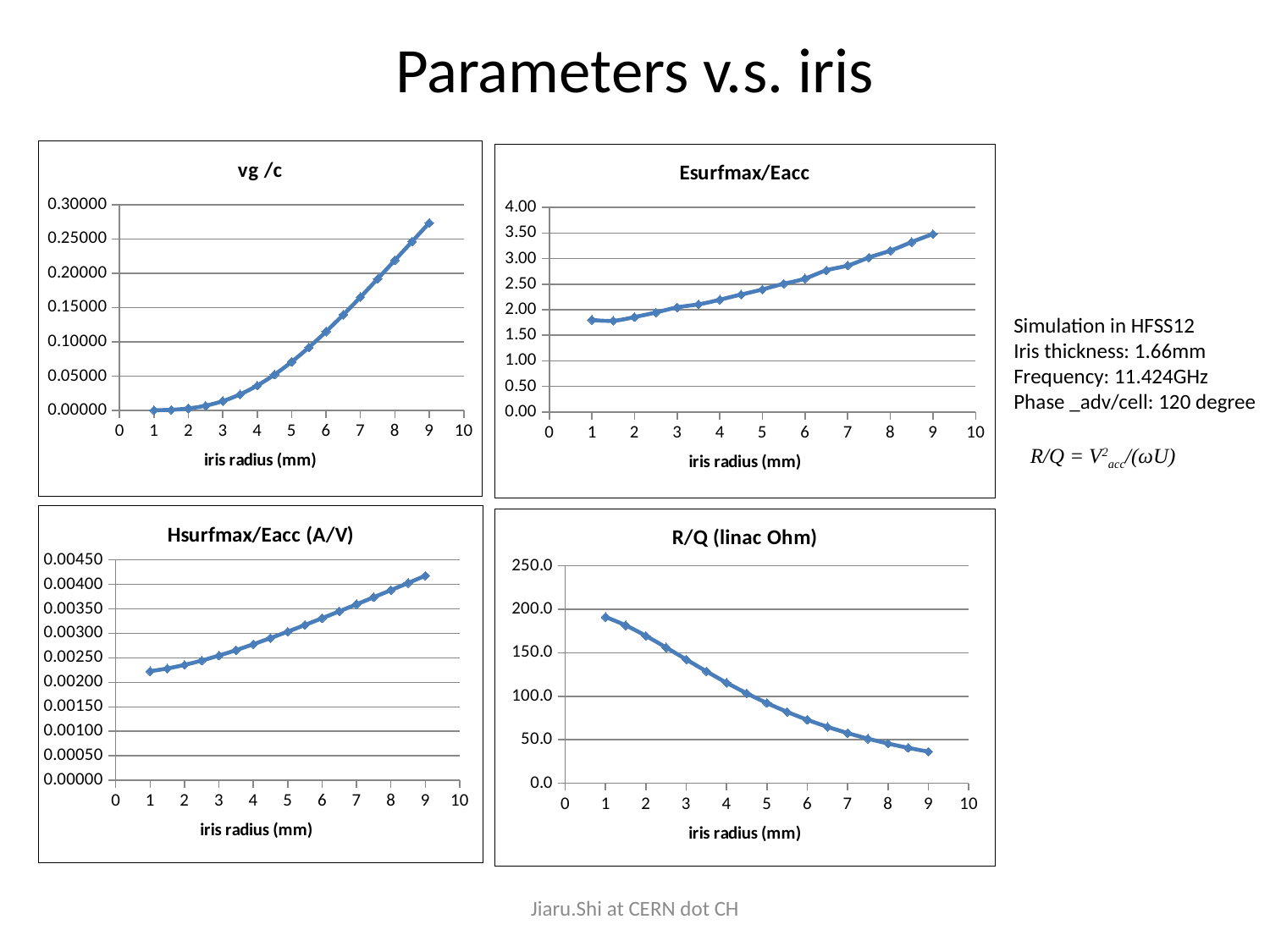
What kind of chart is the "vg /c" chart? line chart In the "Hsurfmax/Eacc (A/V)" chart, is the value at iris radius 1 mm greater or less than 0.00250? less What is the x-axis title of the "vg /c" chart? iris radius (mm) In the "Esurfmax/Eacc" chart, is the value at iris radius 1 mm greater or less than 1.50? greater In the "Esurfmax/Eacc" chart, do the values rise or fall as iris radius increases? rise In the "R/Q (linac Ohm)" chart, do the values rise or fall as iris radius increases? fall In the "vg /c" chart, is the value at iris radius 9 mm greater or less than 0.25000? greater In the "vg /c" chart, do the values rise or fall as iris radius increases? rise